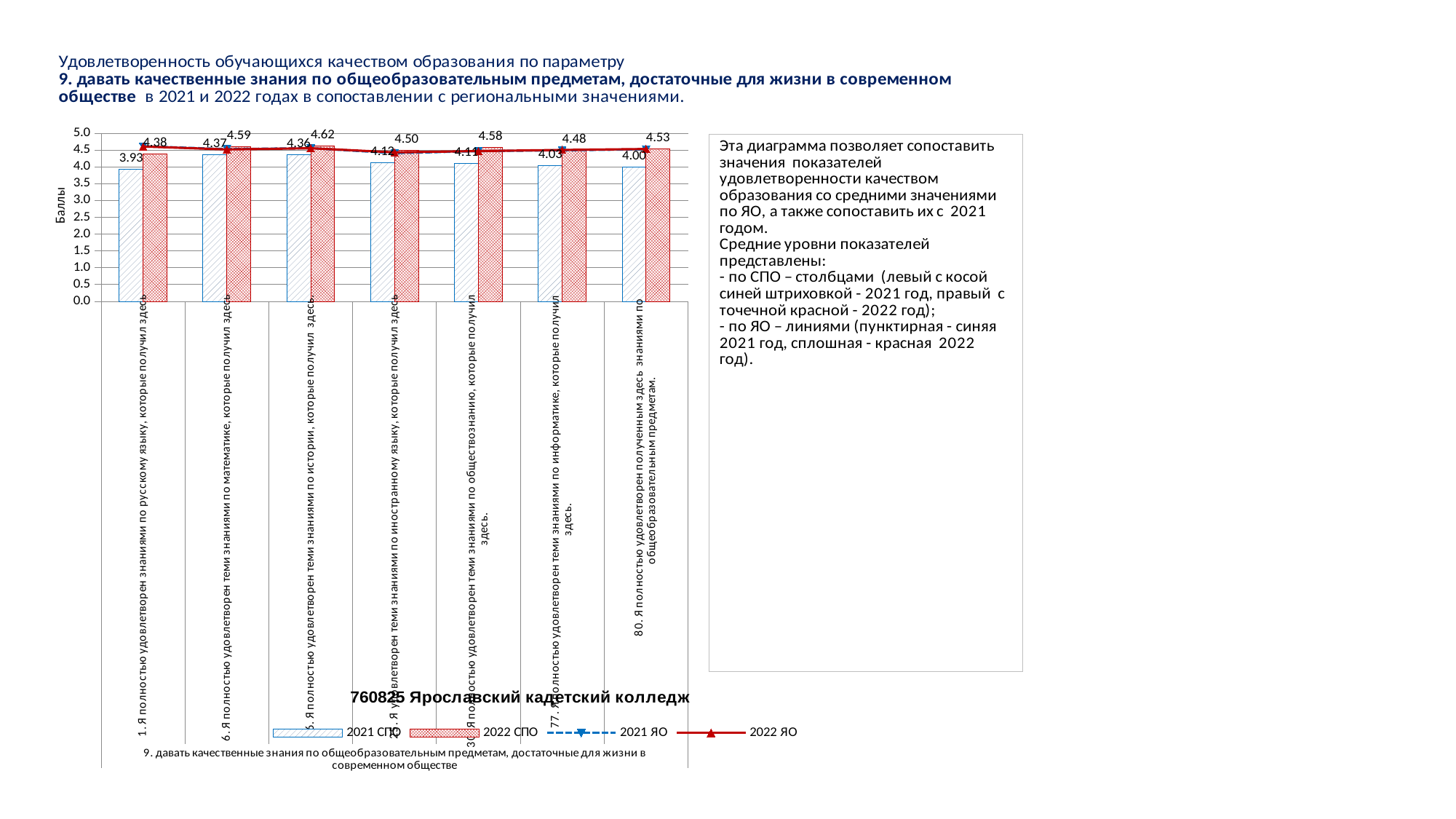
Which is larger: the 2021 СПО value for statement 77 (информатика) or for statement 1 (русский язык)? Statement 77 (4.03) How many series does the legend list? 4 Which statement has the highest 2022 СПО value? 5. Я полностью удовлетворен теми знаниями по истории, которые получил здесь (4.62) What is the 2021 СПО value for statement 1 (знания по русскому языку)? 3.93 What is the 2022 СПО value for statement 6 (знания по математике)? 4.59 How many statements (categories) are shown on the x axis? 7 Is the 2022 ЯО line value for statement 1 (русский язык) greater or less than 4.0? greater Which statement has the lowest 2021 СПО value? 1. Я полностью удовлетворен знаниями по русскому языку, которые получил здесь (3.93) What is the 2022 СПО value for statement 80 (знания по общеобразовательным предметам)? 4.53 By how much did the СПО value for statement 1 (русский язык) increase from 2021 to 2022? 0.45 What kind of chart is this? A combined bar and line chart What is the difference between the 2022 СПО and 2021 СПО values for statement 5 (история)? 0.26